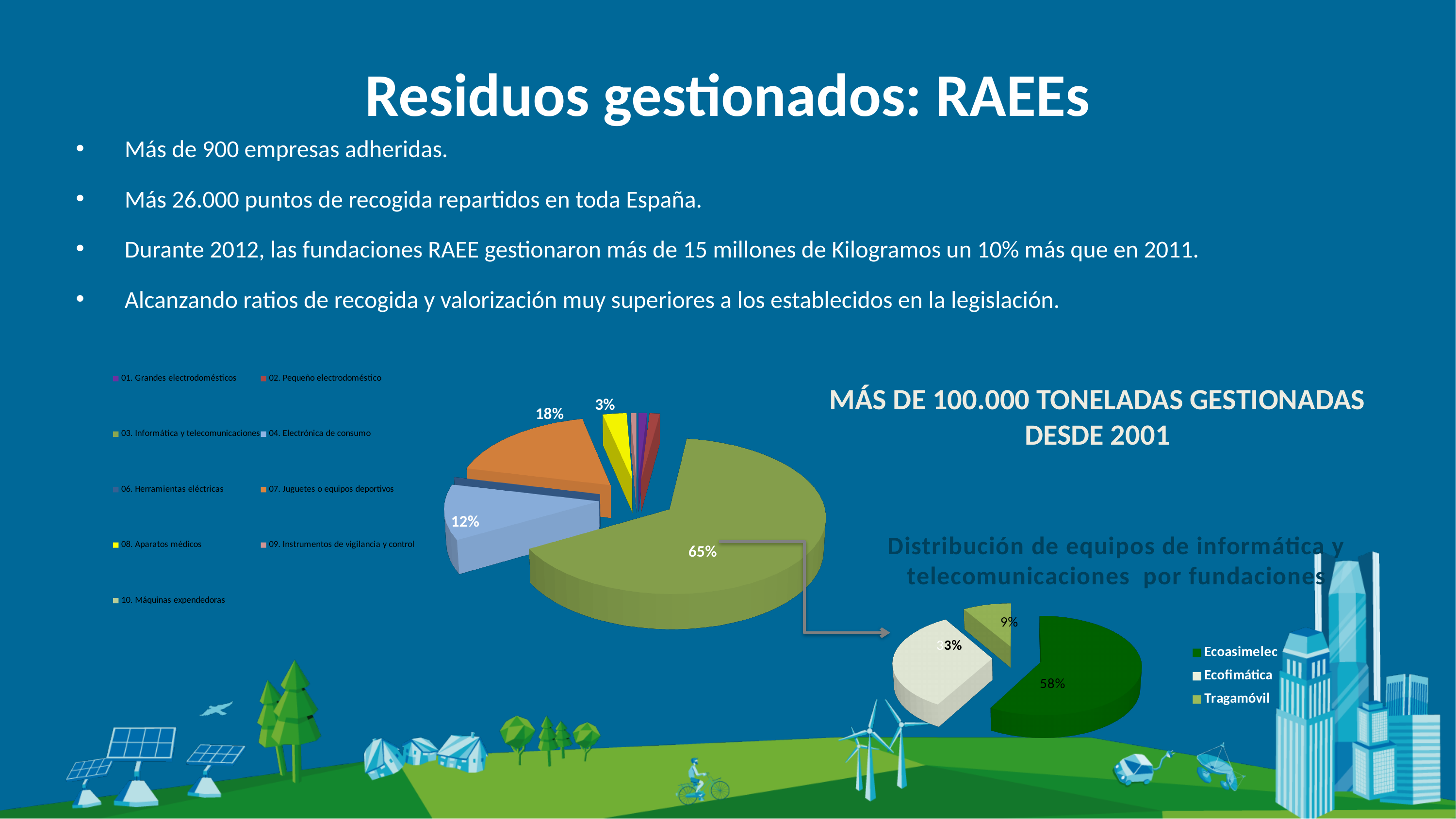
What kind of chart is the large chart on the left of the slide? Pie chart How many entries does the legend of the pie chart on the right, 'Distribución de equipos de informática y telecomunicaciones por fundaciones', list? 3 In the pie chart on the right, 'Distribución de equipos de informática y telecomunicaciones por fundaciones', which foundation has the largest share? Ecoasimelec In the pie chart on the right, 'Distribución de equipos de informática y telecomunicaciones por fundaciones', what share does Ecoasimelec have? 58% In the pie chart on the right, 'Distribución de equipos de informática y telecomunicaciones por fundaciones', what is the difference between the shares of Ecoasimelec and Ecofimática? 25% In the pie chart on the right, 'Distribución de equipos de informática y telecomunicaciones por fundaciones', which foundation has the smallest share? Tragamóvil In the large pie chart on the left of the slide, which category has the largest slice? 03. Informática y telecomunicaciones In the pie chart on the right, 'Distribución de equipos de informática y telecomunicaciones por fundaciones', what share does Ecofimática have? 33% In the large pie chart on the left of the slide, what share does '04. Electrónica de consumo' have? 12% In the pie chart on the right, 'Distribución de equipos de informática y telecomunicaciones por fundaciones', what share does Tragamóvil have? 9% In the large pie chart on the left of the slide, what share does '07. Juguetes o equipos deportivos' have? 18% In the large pie chart on the left of the slide, what share does '03. Informática y telecomunicaciones' have? 65%